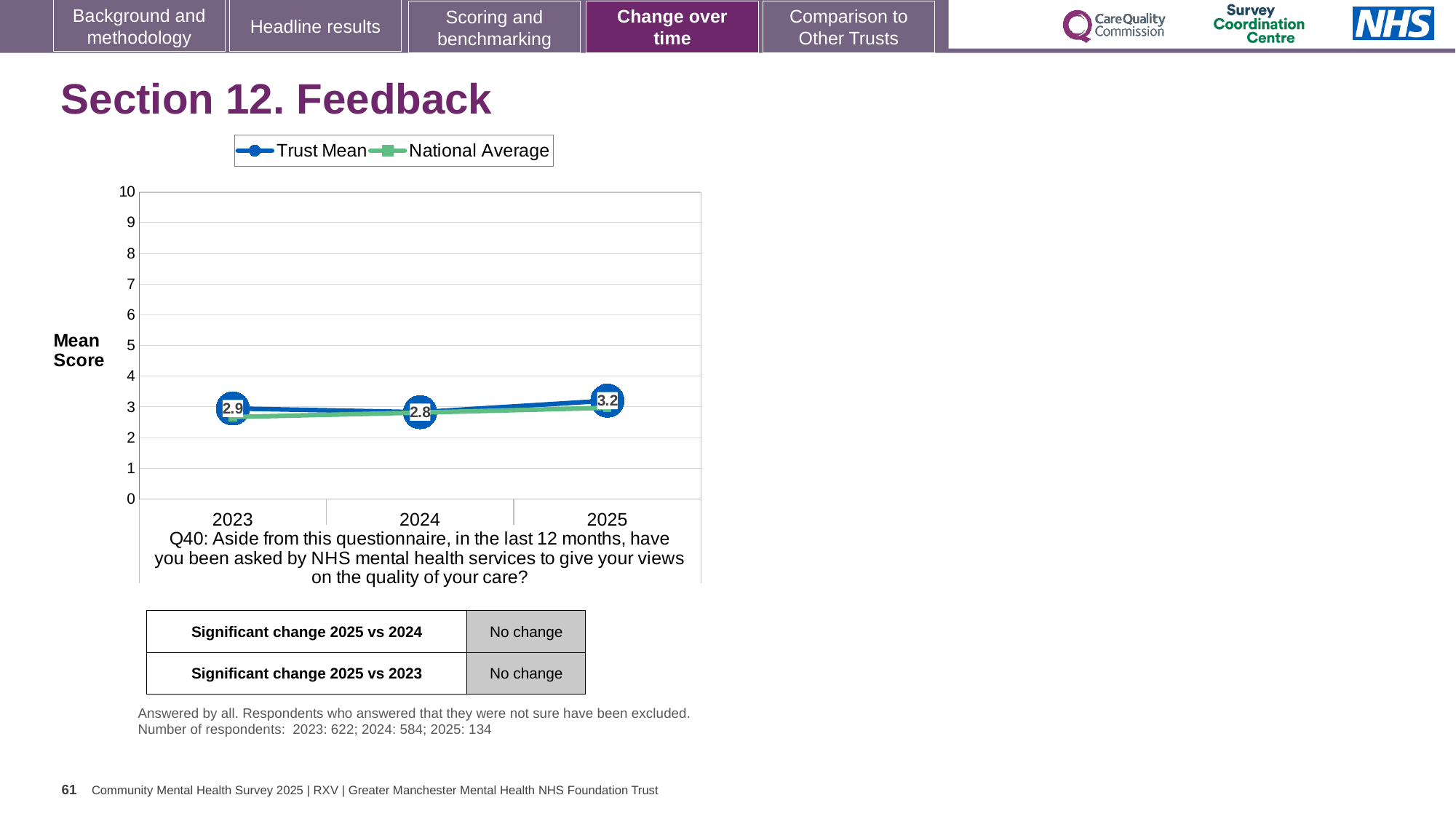
Which is larger, the Trust Mean in 2025 or in 2023? 2025 How many years are plotted on the x axis? 3 In which year is the Trust Mean highest? 2025 In which year is the Trust Mean lowest? 2024 Does the Trust Mean rise or fall from 2024 to 2025? rise Is the National Average value for 2023 greater or less than 3? less How many series does the legend list? 2 What is the Trust Mean value for 2023? 2.9 What kind of chart is shown on the slide? line chart What is the difference between the Trust Mean in 2025 and in 2024? 0.4 What is the Trust Mean value for 2025? 3.2 What is the Trust Mean value for 2024? 2.8